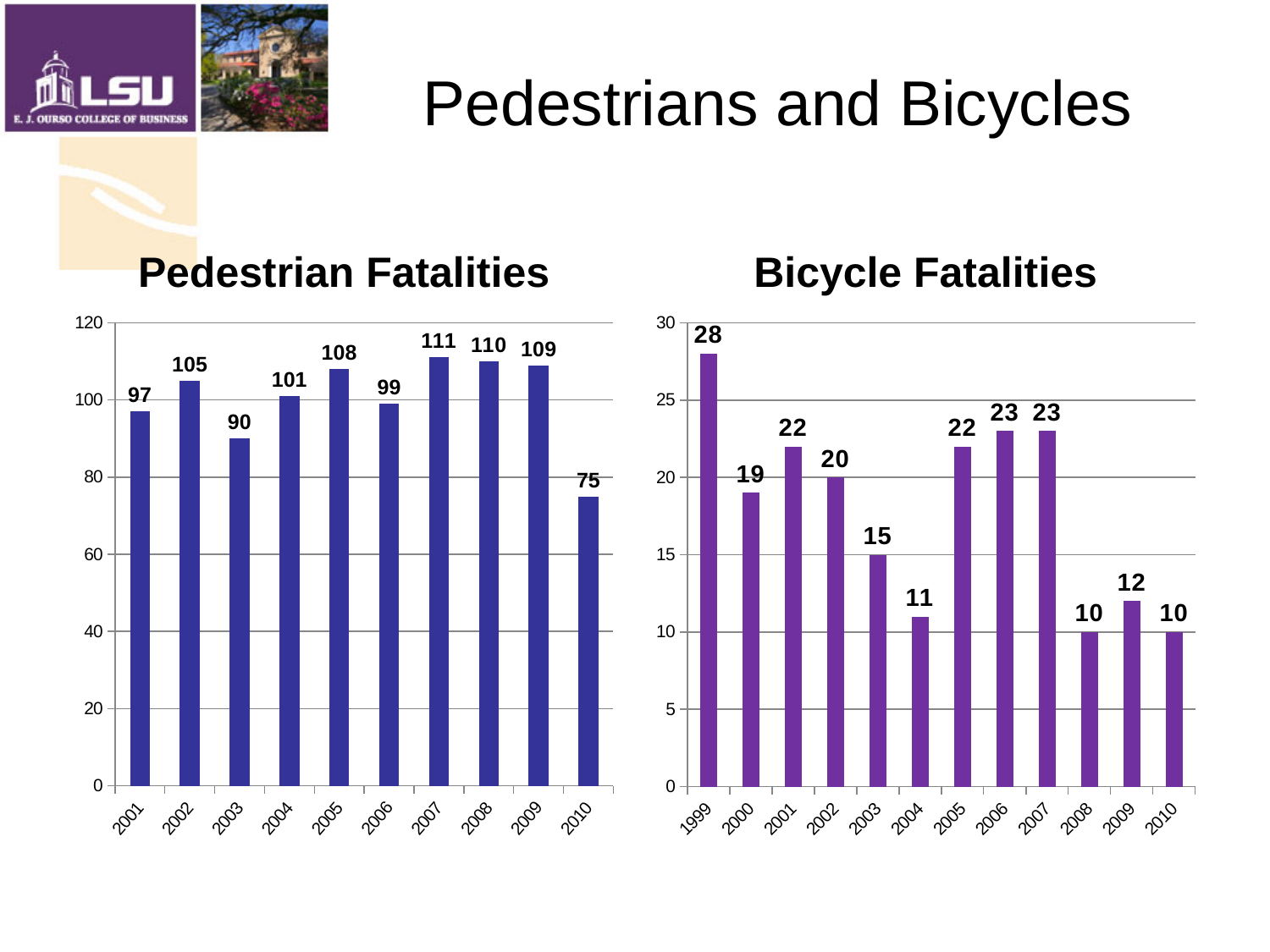
In the Bicycle Fatalities chart, do the values rise or fall from 2007 to 2008? fall In the Bicycle Fatalities chart, which year has the highest value? 1999 How many years are shown in the Pedestrian Fatalities chart? 10 In the Bicycle Fatalities chart, is the value for 2000 greater or less than 20? less In the Bicycle Fatalities chart, what is the value for 1999? 28 In the Bicycle Fatalities chart, what is the difference between the values for 2003 and 2004? 4 In the Pedestrian Fatalities chart, what is the value for 2007? 111 What kind of chart is the Pedestrian Fatalities chart? bar chart In the Pedestrian Fatalities chart, which year has the lowest value? 2010 In the Pedestrian Fatalities chart, which is larger, the value for 2002 or the value for 2003? 2002 In the Pedestrian Fatalities chart, what is the difference between the values for 2007 and 2010? 36 How many years are shown in the Bicycle Fatalities chart? 12